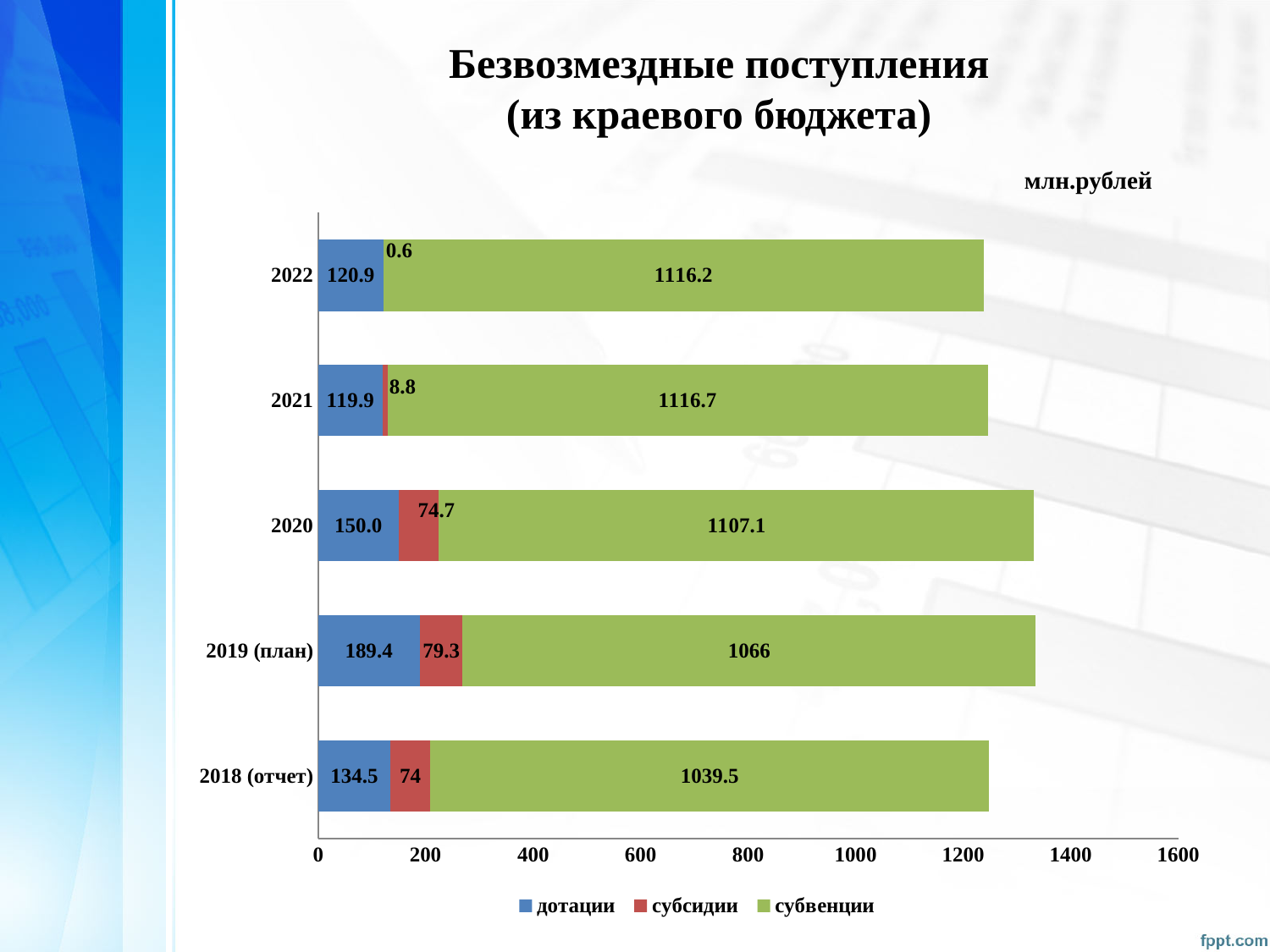
Which year has the lowest value of субсидии? 2022 Which year has the highest value of дотации? 2019 (план) What is the value of субвенции for 2020? 1107.1 What is the value of субсидии for 2022? 0.6 Do the values of субсидии rise or fall from 2019 (план) to 2022? Fall What type of chart is shown on the slide? Stacked bar chart What is the difference between дотации in 2020 and in 2018 (отчет)? 15.5 How many categories (years) are shown on the chart? 5 Which is larger: субвенции in 2021 or субвенции in 2018 (отчет)? 2021 What is the value of дотации for 2019 (план)? 189.4 How many series does the legend list? 3 What is the total of the stacked bar for 2018 (отчет)? 1248